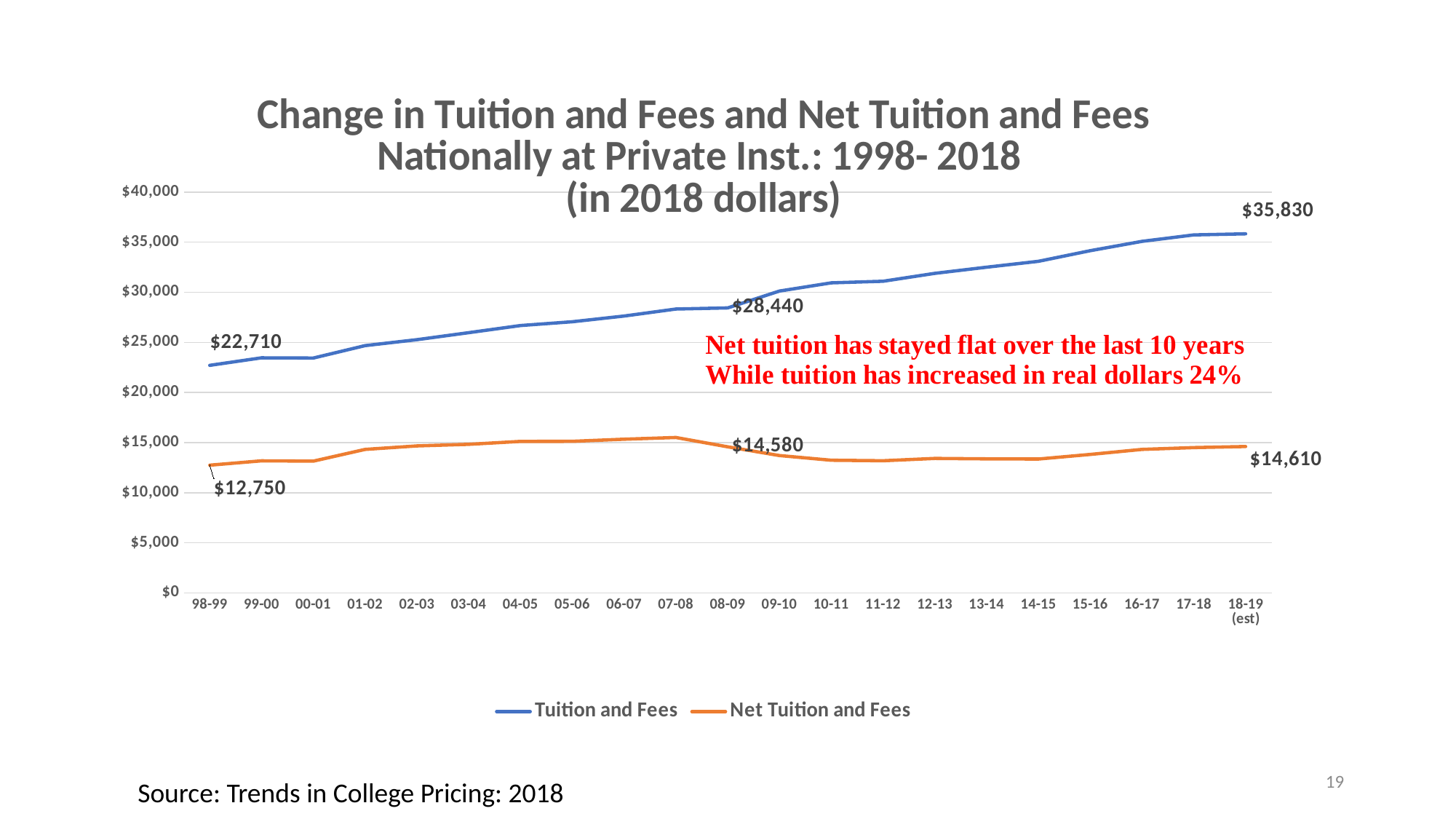
Does the Tuition and Fees line rise or fall from 98-99 to 18-19 (est)? Rises How many series does the legend list? 2 What is the value of Net Tuition and Fees in 18-19 (est)? $14,610 Is the value for Tuition and Fees in 13-14 greater or less than $30,000? greater What is the value of Net Tuition and Fees in 08-09? $14,580 Which is larger in 18-19 (est): Tuition and Fees or Net Tuition and Fees? Tuition and Fees What is the difference between Tuition and Fees and Net Tuition and Fees in 08-09? $13,860 What is the difference between Tuition and Fees in 18-19 (est) and in 98-99? $13,120 What type of chart is shown on the slide? Line chart What is the value of Tuition and Fees in 18-19 (est)? $35,830 What is the value of Tuition and Fees in 98-99? $22,710 How many academic years are plotted on the x axis? 21